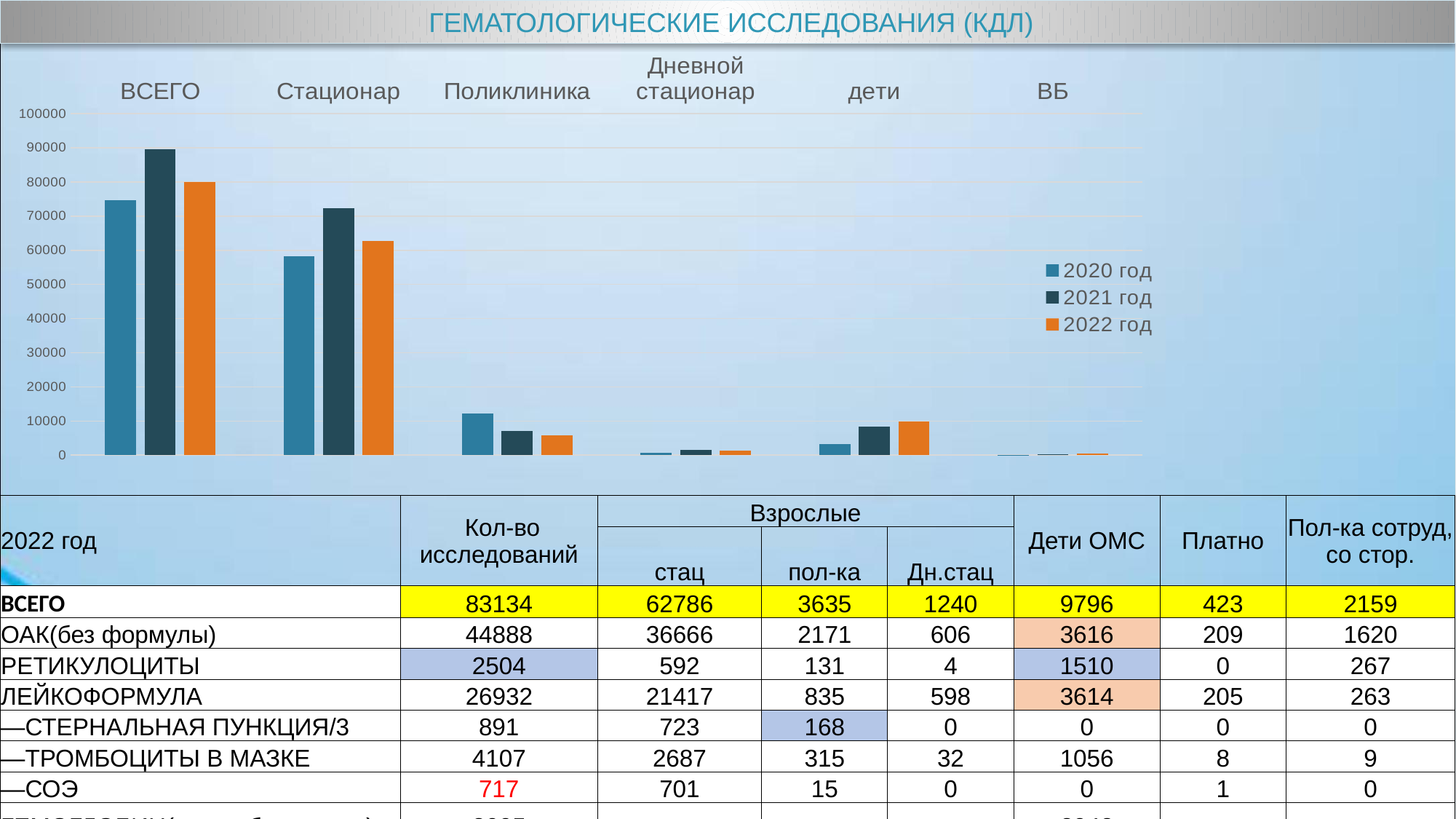
Is the value for Стационар in 2021 год greater or less than 70000? greater How many categories are shown along the x axis of the chart? 6 Is the value for Стационар in 2020 год greater or less than 60000? less For the ВСЕГО category, which year has the highest bar? 2021 год Is the value for Поликлиника in 2020 год greater or less than 10000? greater What kind of chart is shown on the slide? bar chart Which category has the tallest bars in the chart? ВСЕГО Which colour represents the 2022 год series in the chart legend? orange How many series does the chart legend list? 3 Which is larger: the 2022 год value for Стационар or the 2022 год value for Поликлиника? Стационар For the Поликлиника category, do the values rise or fall from 2020 год to 2022 год? fall